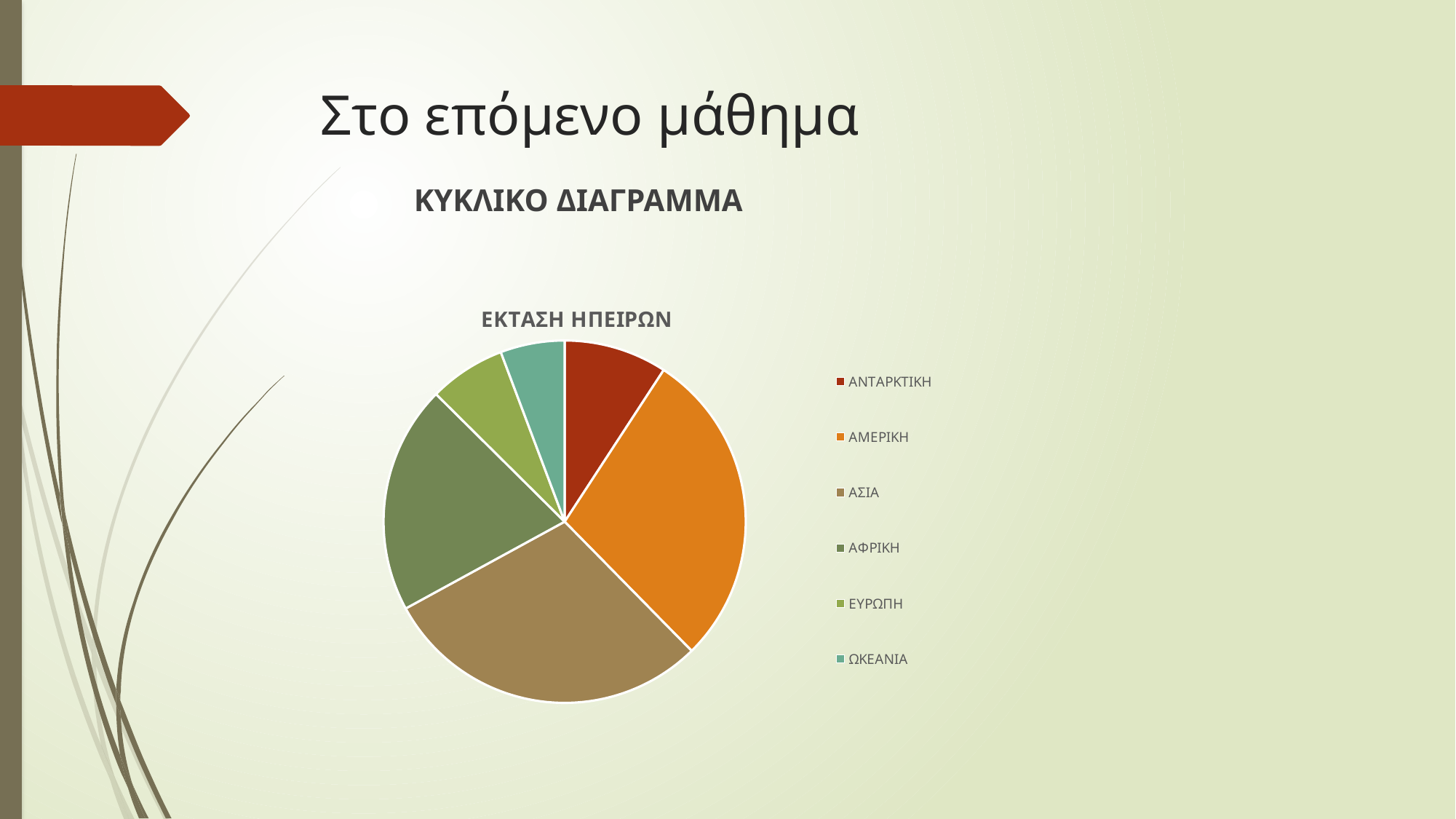
Which slice is larger in the pie chart, ΑΣΙΑ or ΩΚΕΑΝΙΑ? ΑΣΙΑ Which slice is larger in the pie chart, ΑΣΙΑ or ΑΦΡΙΚΗ? ΑΣΙΑ Which colour is used for the ΑΜΕΡΙΚΗ slice in the pie chart? orange What kind of chart is shown on the slide? pie chart Which slice is larger in the pie chart, ΑΦΡΙΚΗ or ΕΥΡΩΠΗ? ΑΦΡΙΚΗ How many entries does the legend of the pie chart list? 6 How many slices does the pie chart have? 6 What is the title of the pie chart? ΕΚΤΑΣΗ ΗΠΕΙΡΩΝ